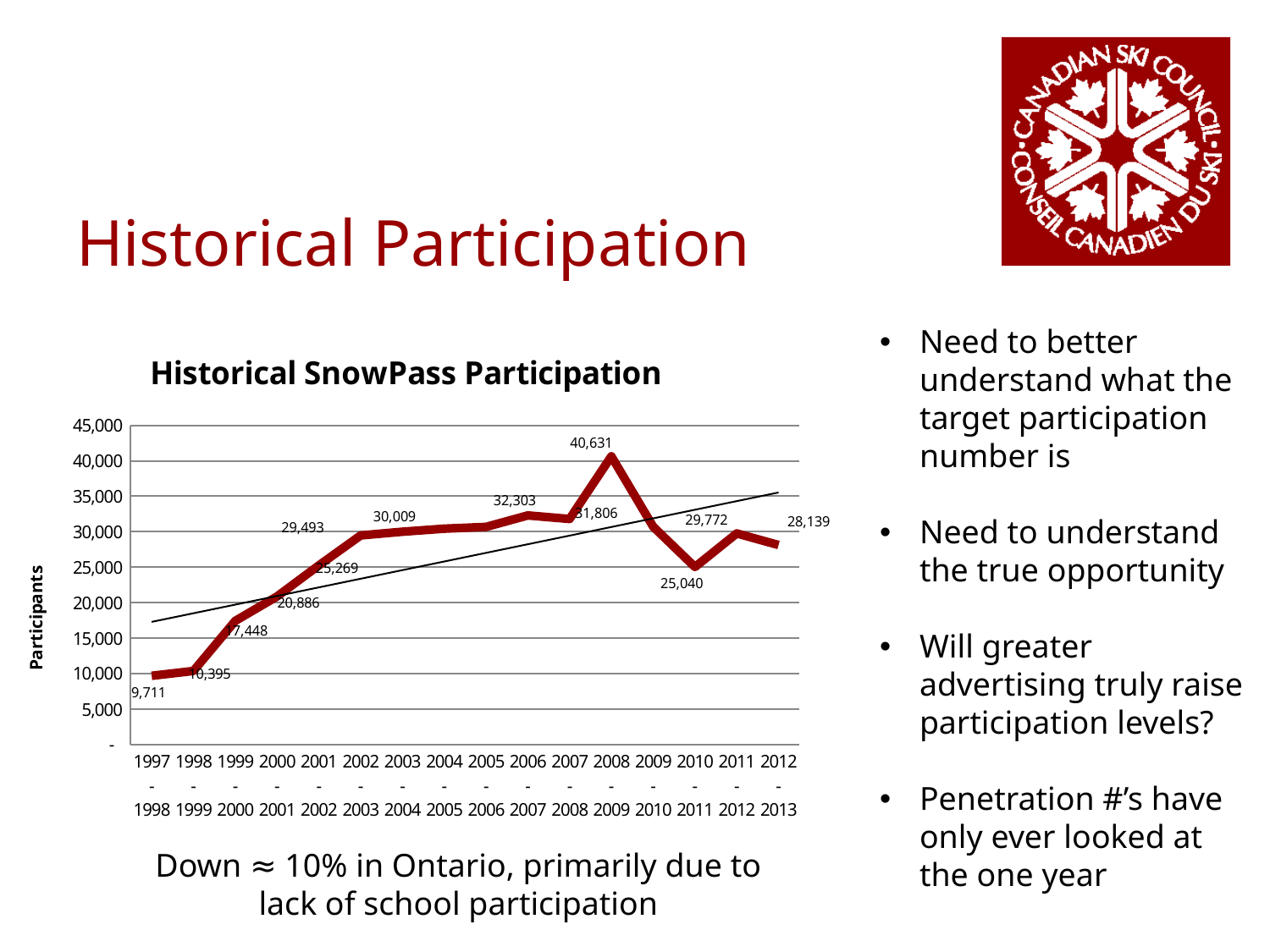
What is the difference between the highest participation (2008-2009) and the lowest (1997-1998)? 30,920 How many seasons are plotted along the x axis of the chart? 16 What is the title of the chart? Historical SnowPass Participation What is the label on the vertical axis of the chart? Participants Which season has higher participation, 2011-2012 or 2010-2011? 2011-2012 What is the participation value for the 2012-2013 season? 28,139 What is the participation value for the 1997-1998 season? 9,711 Which season has the highest participation in the chart? 2008-2009 What is the participation value for the 2008-2009 season? 40,631 Which season has the lowest participation in the chart? 1997-1998 Is the participation value for the 2004-2005 season greater or less than 25,000? greater What kind of chart is shown on the slide? line chart